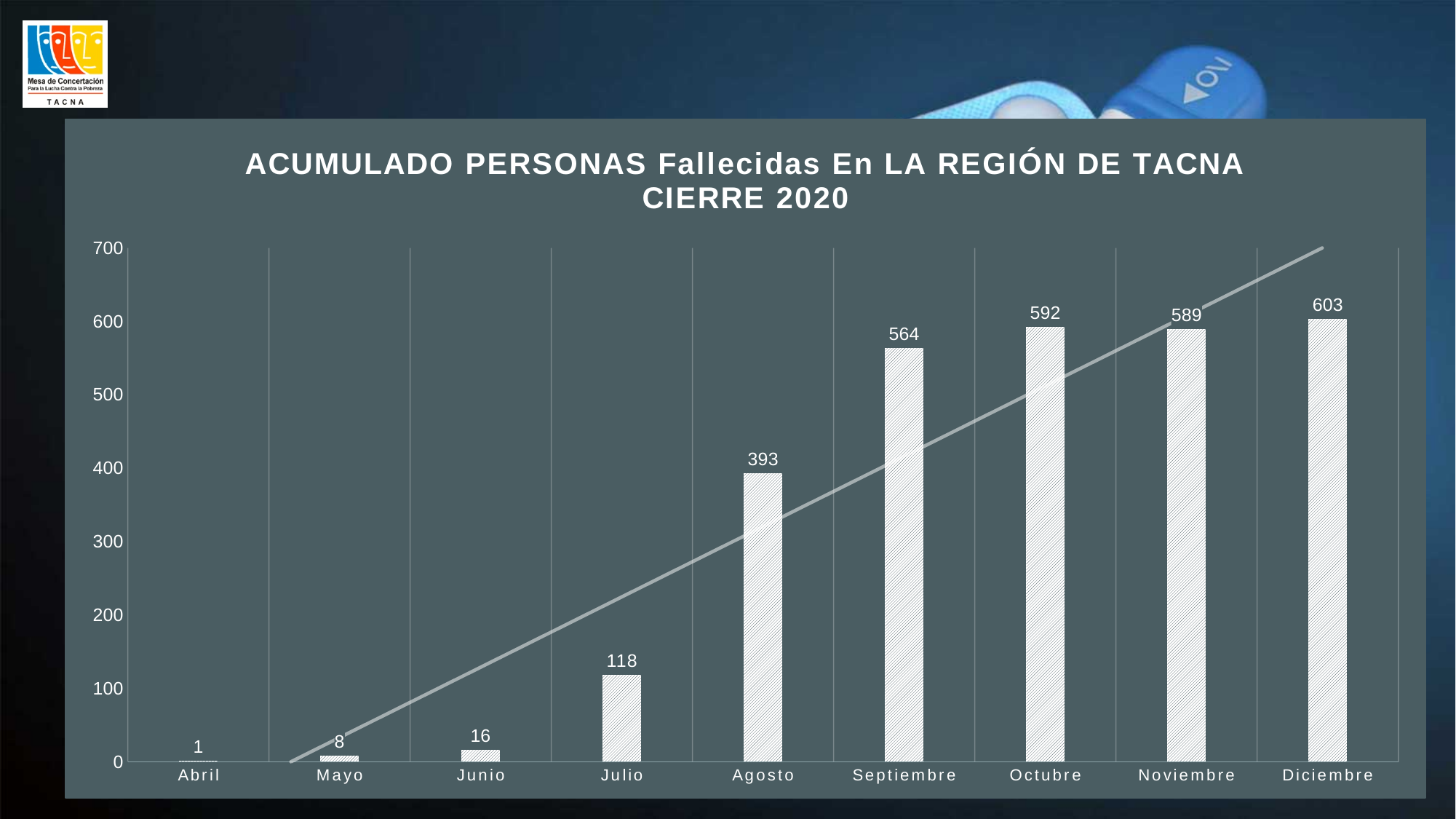
Which month has the highest value? Diciembre What is the difference between the values for Diciembre and Septiembre? 39 What is the difference between the values for Agosto and Julio? 275 What is the accumulated number of deaths shown for Agosto? 393 What value is shown for Julio? 118 What kind of chart is this? bar chart Which is larger, the value for Octubre or the value for Noviembre? Octubre How many months are shown on the x axis? 9 What value is shown for Noviembre? 589 Which month has the lowest value? Abril Is the value for Septiembre greater or less than 500? greater What is the title of the chart? ACUMULADO PERSONAS Fallecidas En LA REGIÓN DE TACNA CIERRE 2020